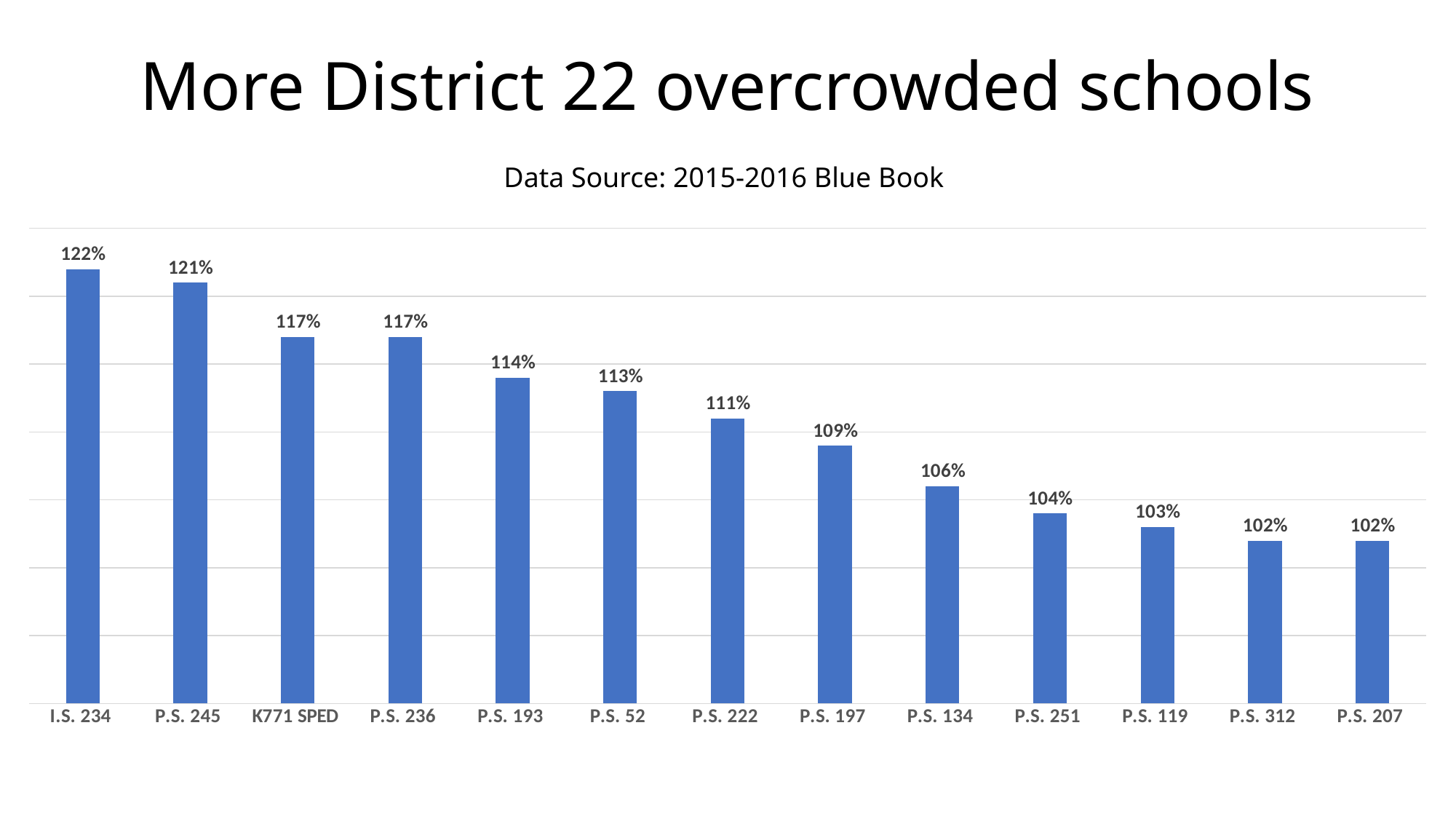
Which school has the highest value? I.S. 234 What kind of chart is shown on the slide? bar chart Do the values rise or fall from left to right across the chart? fall How many schools are shown in the chart? 13 What is the title of the slide? More District 22 overcrowded schools What is the value for P.S. 193? 114% Which is larger, the value for P.S. 222 or the value for P.S. 119? P.S. 222 What is the value for K771 SPED? 117% What is the difference between the values for I.S. 234 and P.S. 197? 13% What is the value for P.S. 134? 106% What data source is cited on the slide? 2015-2016 Blue Book What is the difference between the values for P.S. 52 and P.S. 251? 9%